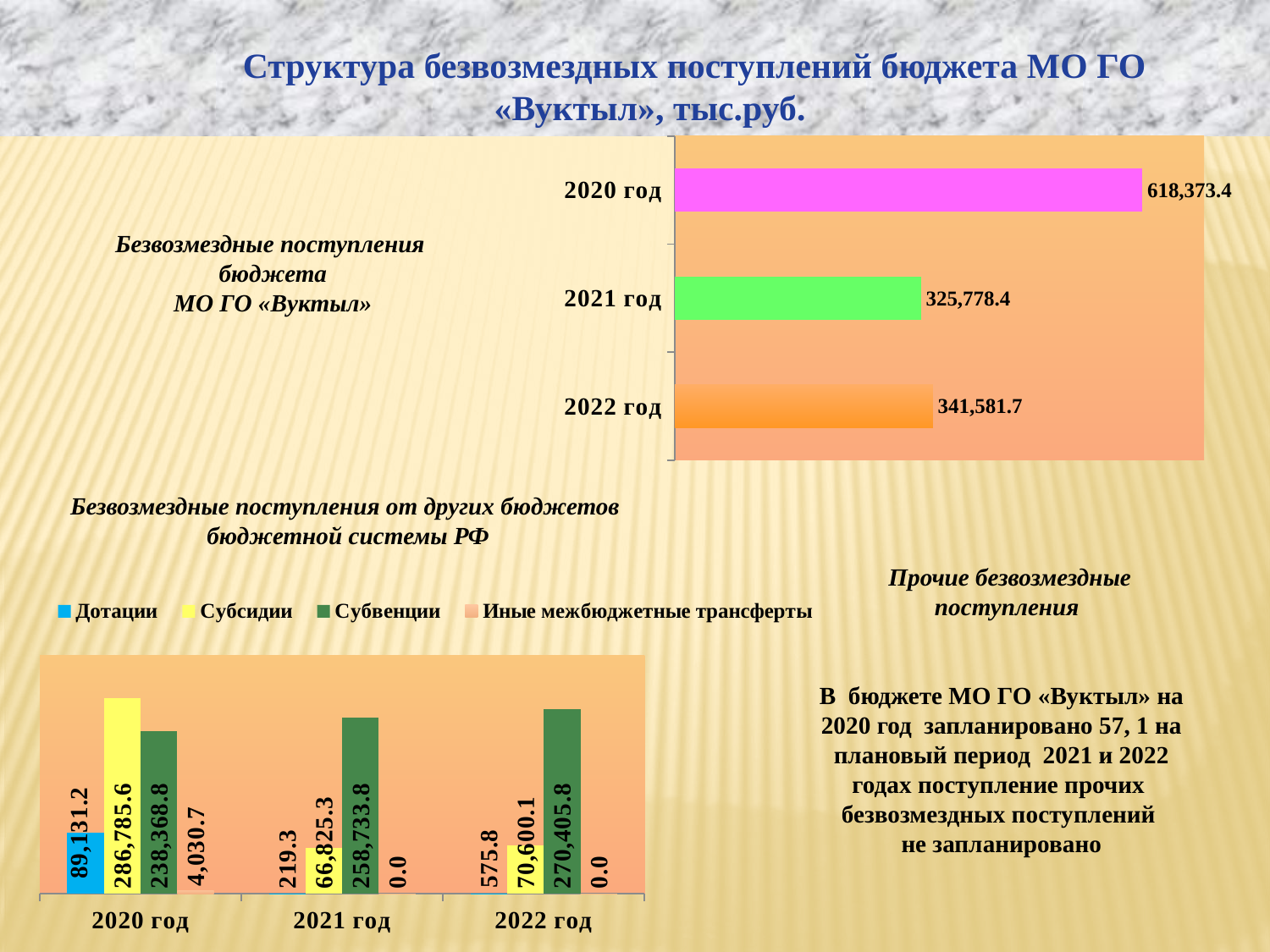
What kind of chart is the top chart (Безвозмездные поступления бюджета МО ГО «Вуктыл»)? Bar chart In the bottom chart (Безвозмездные поступления от других бюджетов бюджетной системы РФ), how many series does the legend list? 4 In the top chart (Безвозмездные поступления бюджета МО ГО «Вуктыл»), what is the value for 2020 год? 618,373.4 In the bottom chart (Безвозмездные поступления от других бюджетов бюджетной системы РФ), what is the value of Субсидии for 2020 год? 286,785.6 In the top chart (Безвозмездные поступления бюджета МО ГО «Вуктыл»), which year has the lowest value? 2021 год In the top chart (Безвозмездные поступления бюджета МО ГО «Вуктыл»), what is the difference between the 2022 год and 2021 год values? 15,803.3 In the top chart (Безвозмездные поступления бюджета МО ГО «Вуктыл»), what is the value for 2021 год? 325,778.4 In the bottom chart (Безвозмездные поступления от других бюджетов бюджетной системы РФ), which is larger for 2021 год: Субсидии or Субвенции? Субвенции In the bottom chart (Безвозмездные поступления от других бюджетов бюджетной системы РФ), what is the value of Иные межбюджетные трансферты for 2020 год? 4,030.7 In the top chart (Безвозмездные поступления бюджета МО ГО «Вуктыл»), which year has the highest value? 2020 год In the bottom chart (Безвозмездные поступления от других бюджетов бюджетной системы РФ), do the Субвенции values rise or fall from 2020 год to 2022 год? Rise In the bottom chart (Безвозмездные поступления от других бюджетов бюджетной системы РФ), what is the value of Субвенции for 2022 год? 270,405.8